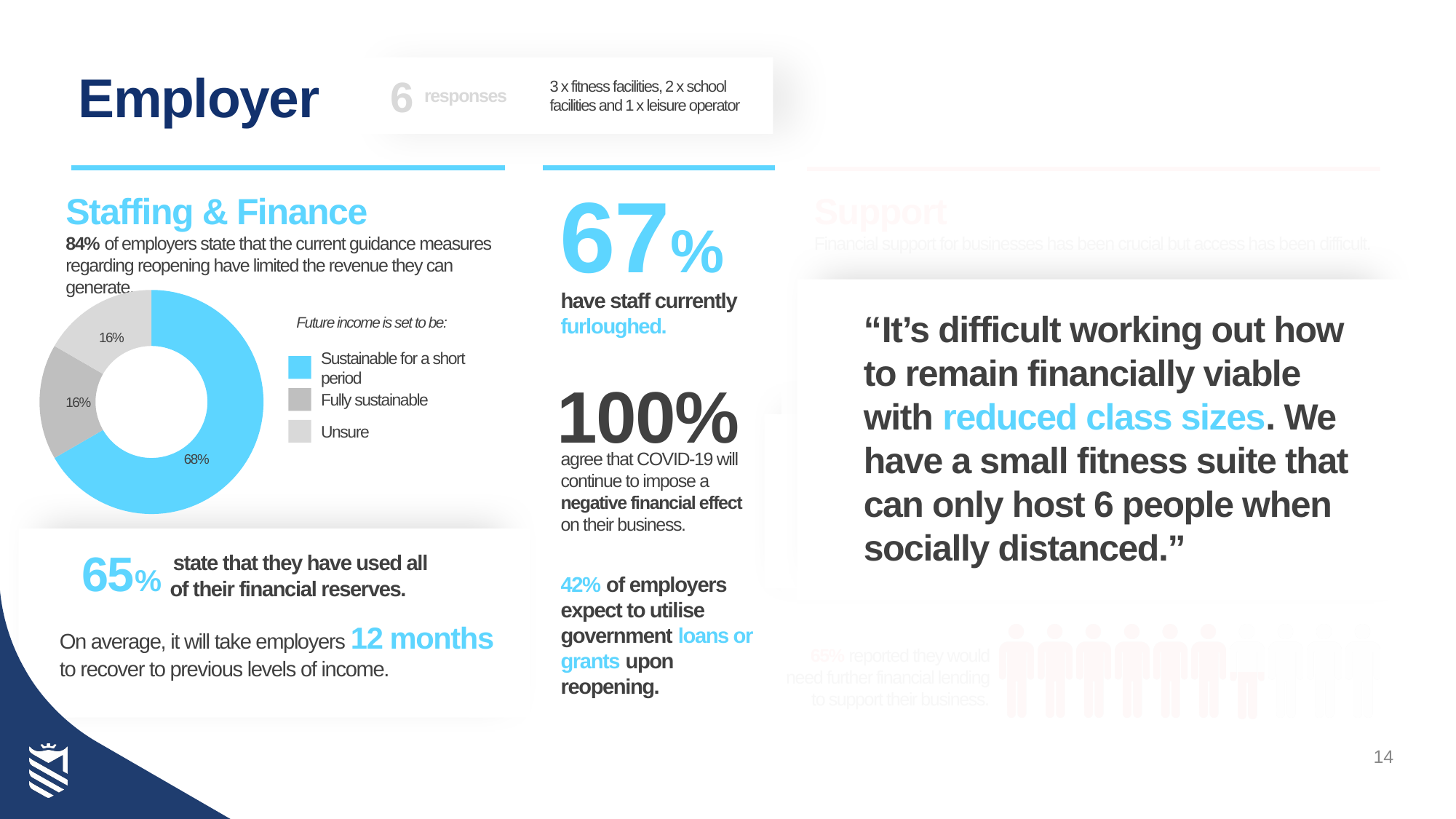
What kind of chart is shown on the slide? Pie chart (donut) What share of employers say future income is set to be fully sustainable? 16% Which colour represents Sustainable for a short period in the pie chart? Blue What share of employers are unsure about future income? 16% Which category has the largest slice in the pie chart? Sustainable for a short period What share of employers say future income is set to be sustainable for a short period? 68% What is the combined share of the Fully sustainable and Unsure slices? 32% What is the heading text above the pie chart legend? Future income is set to be: Which is larger in the pie chart: Sustainable for a short period or Fully sustainable? Sustainable for a short period How many categories does the pie chart show? 3 By how many percentage points does the Sustainable for a short period slice exceed the Unsure slice? 52 percentage points